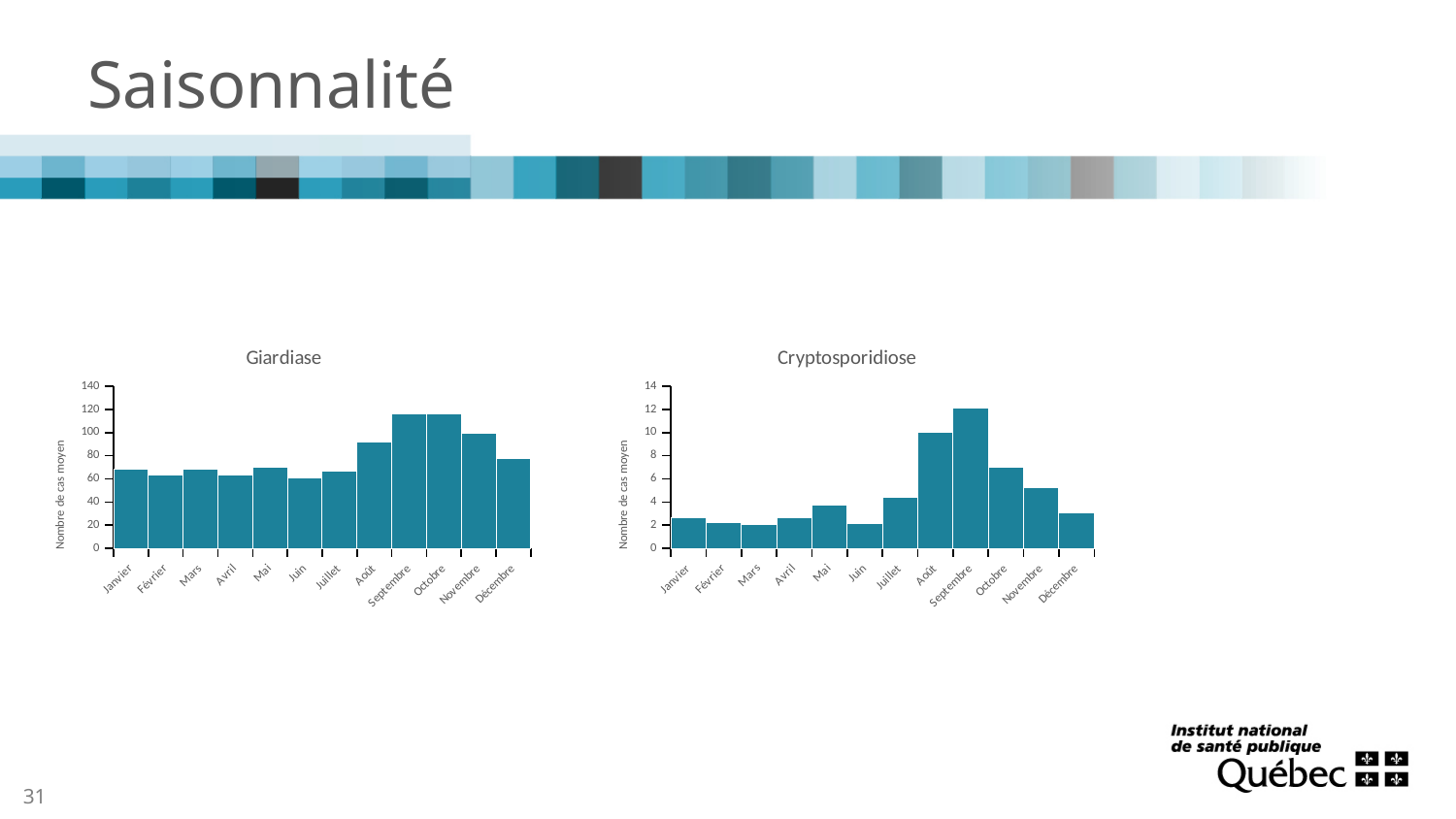
In the Cryptosporidiose chart, is the value for Mars greater or less than 4? less What kind of chart is the Giardiase chart? bar chart In the Cryptosporidiose chart, which month has the highest value? Septembre In the Cryptosporidiose chart, is the value for Août greater or less than 8? greater How many months are shown on the x axis of the Cryptosporidiose chart? 12 In the Cryptosporidiose chart, do the values rise or fall from Juin to Septembre? rise In the Giardiase chart, is the value for Août greater or less than 80? greater What is the y-axis label of the Giardiase chart? Nombre de cas moyen In the Cryptosporidiose chart, which is larger, the value for Octobre or the value for Juillet? Octobre In the Giardiase chart, which is larger, the value for Novembre or the value for Décembre? Novembre